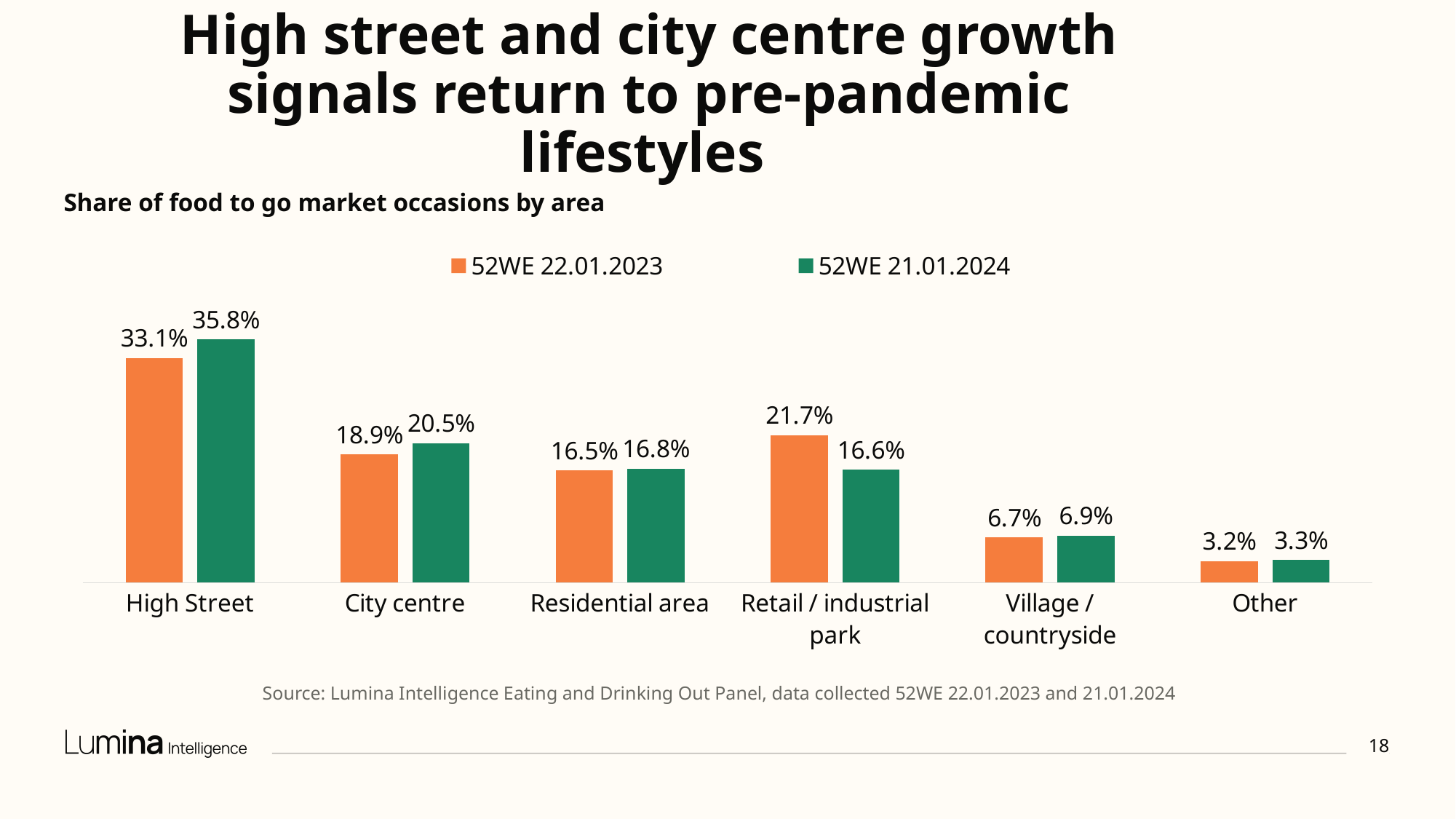
How many series does the legend list? 2 Which area has the lowest share in 52WE 22.01.2023? Other What is the share of food to go market occasions for High Street in 52WE 21.01.2024? 35.8% By how many percentage points did the High Street share change from 52WE 22.01.2023 to 52WE 21.01.2024? 2.7 percentage points Which colour represents the 52WE 21.01.2024 series in the chart? Green What is the share for Retail / industrial park in 52WE 22.01.2023? 21.7% What is the difference between the 52WE 22.01.2023 and 52WE 21.01.2024 shares for Retail / industrial park? 5.1 percentage points How many areas are shown on the x axis of the chart? 6 What is the share for Village / countryside in 52WE 21.01.2024? 6.9% For Retail / industrial park, which period has the larger share: 52WE 22.01.2023 or 52WE 21.01.2024? 52WE 22.01.2023 Which area has the highest share in 52WE 21.01.2024? High Street What kind of chart is shown on the slide? Bar chart